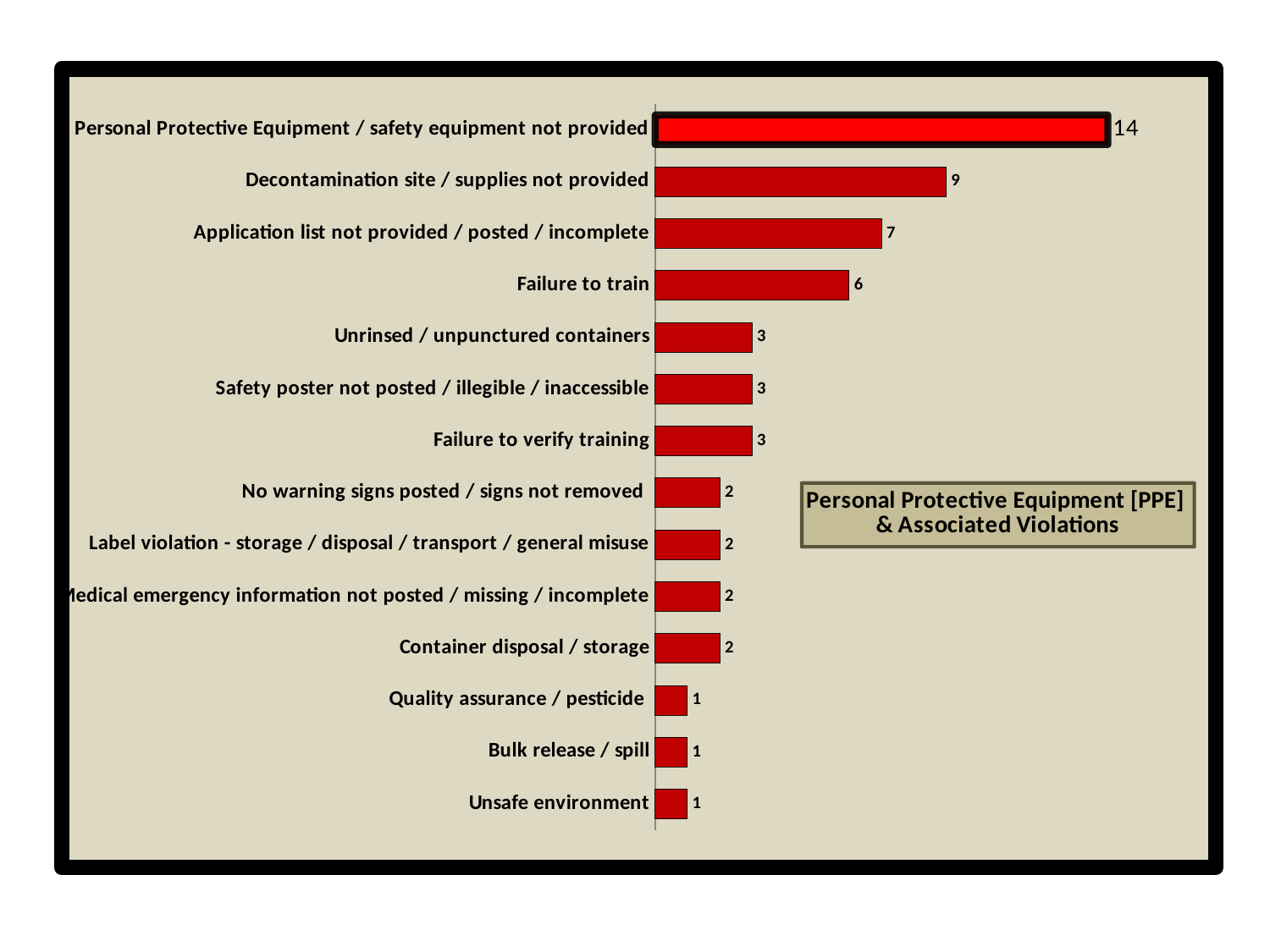
How many categories are shown in the chart? 14 What is the value for Personal Protective Equipment / safety equipment not provided? 14 Which is larger, the value for Application list not provided / posted / incomplete or the value for Unrinsed / unpunctured containers? Application list not provided / posted / incomplete How many categories have a value of 1? 3 What is the value for Decontamination site / supplies not provided? 9 What is the value for Container disposal / storage? 2 Which category has the highest value? Personal Protective Equipment / safety equipment not provided What kind of chart is shown on the slide? Bar chart What is the difference between the values for Decontamination site / supplies not provided and Application list not provided / posted / incomplete? 2 What is the title of the chart? Personal Protective Equipment [PPE] & Associated Violations What is the difference between the values for Personal Protective Equipment / safety equipment not provided and Failure to train? 8 What is the value for Failure to train? 6